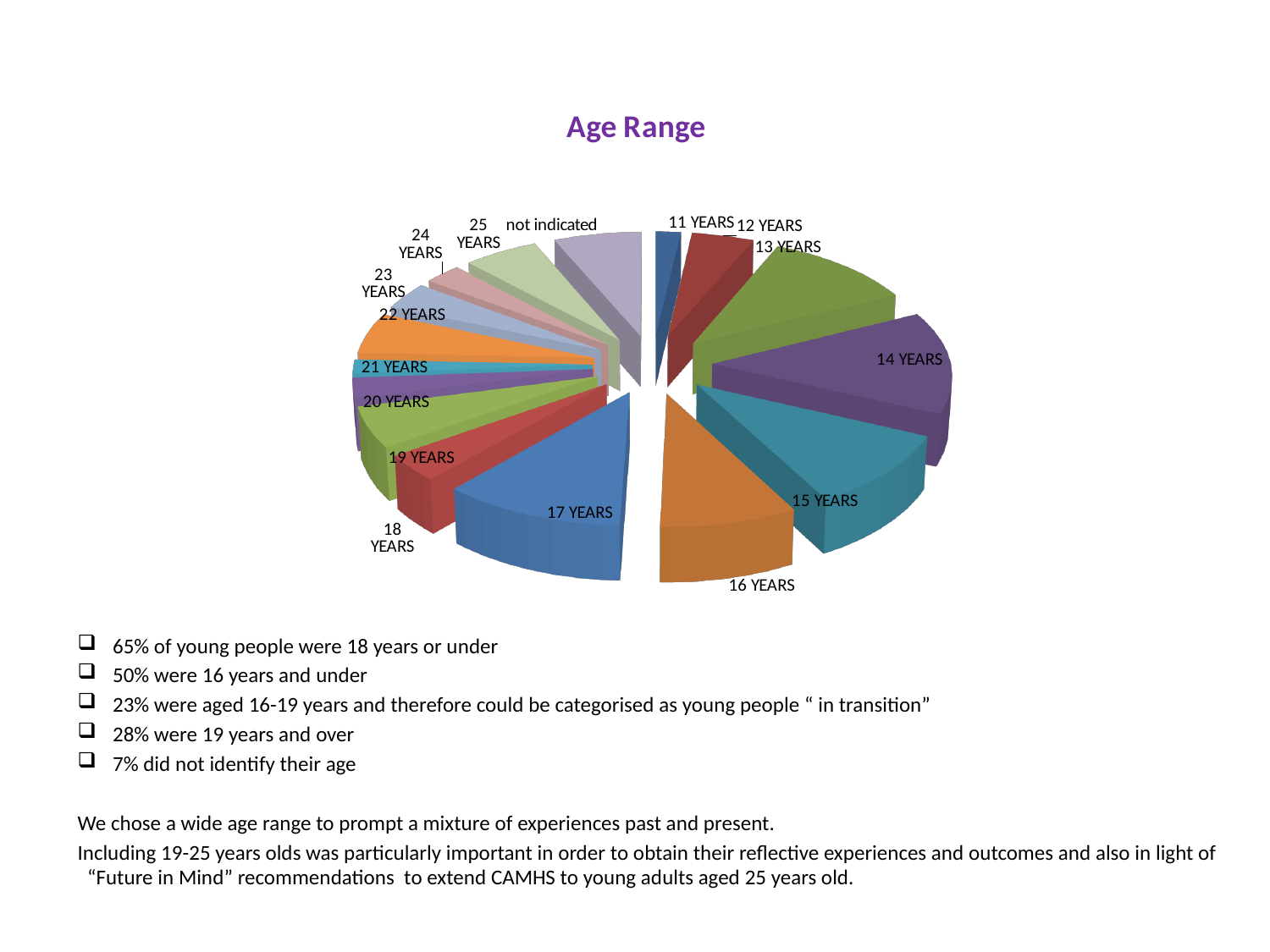
Which slice is larger, 11 YEARS or 19 YEARS? 19 YEARS Which slice is larger, 16 YEARS or 21 YEARS? 16 YEARS Which slice is larger, 17 YEARS or 12 YEARS? 17 YEARS What kind of chart is shown on the slide? pie chart How many slices does the pie chart have? 16 What is the title of the chart? Age Range What colour is the 14 YEARS slice? purple